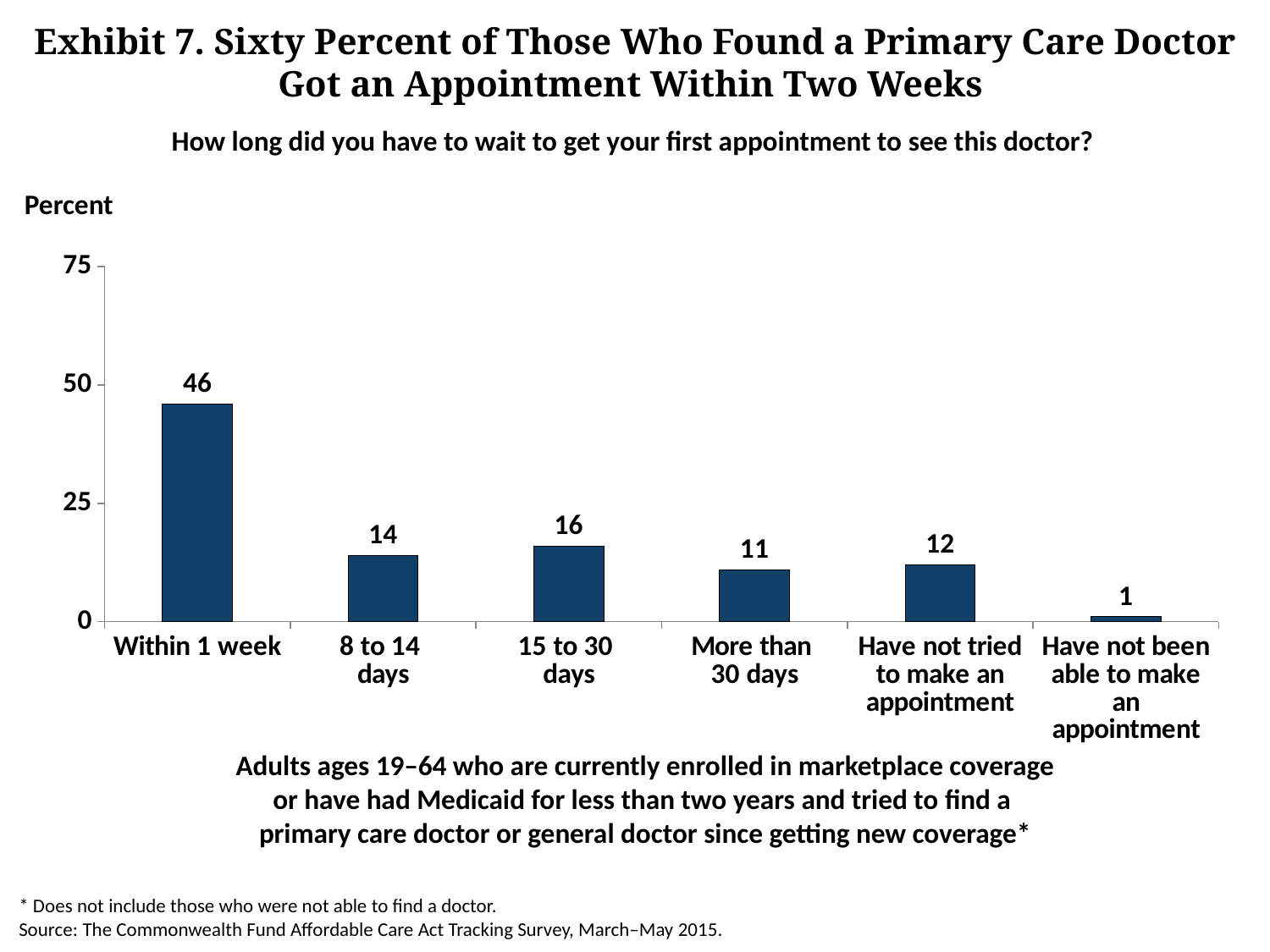
What is the difference between the 'Within 1 week' value and the '8 to 14 days' value? 32 Which category has the highest value? Within 1 week What kind of chart is shown on the slide? Bar chart What is the label on the y axis of the chart? Percent What percentage of respondents got their first appointment within 1 week? 46 Is the value for 'Within 1 week' greater or less than 50? less Which category has the lowest value? Have not been able to make an appointment Which is larger: the value for '15 to 30 days' or the value for 'More than 30 days'? 15 to 30 days How many categories are shown on the x axis? 6 What is the combined value of the '8 to 14 days' and '15 to 30 days' categories? 30 What is the value for the '15 to 30 days' category? 16 What percentage of respondents have not tried to make an appointment? 12